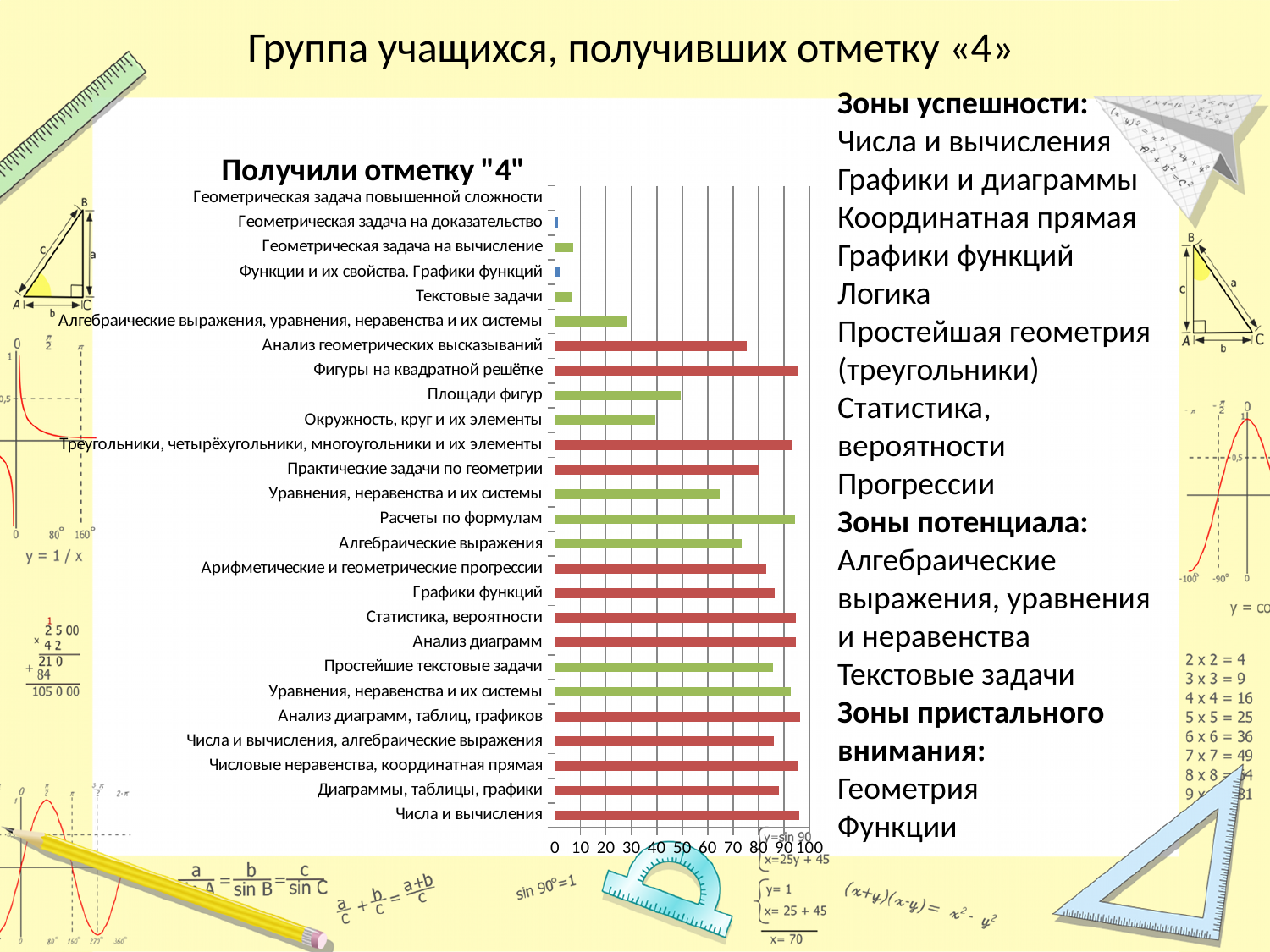
Is the value for Анализ геометрических высказываний greater or less than 60? greater Is the value for Числа и вычисления greater or less than 90? greater What is the highest value shown on the horizontal axis of the chart? 100 Is the value for Окружность, круг и их элементы greater or less than 50? less Which has a larger value: Расчеты по формулам or Уравнения, неравенства и их системы (the bar directly above it)? Расчеты по формулам What kind of chart is shown on the slide? bar chart Which has a larger value: Текстовые задачи or Простейшие текстовые задачи? Простейшие текстовые задачи What is the title of the chart? Получили отметку "4" Which has a larger value: Площади фигур or Фигуры на квадратной решётке? Фигуры на квадратной решётке How many categories are plotted in the chart? 26